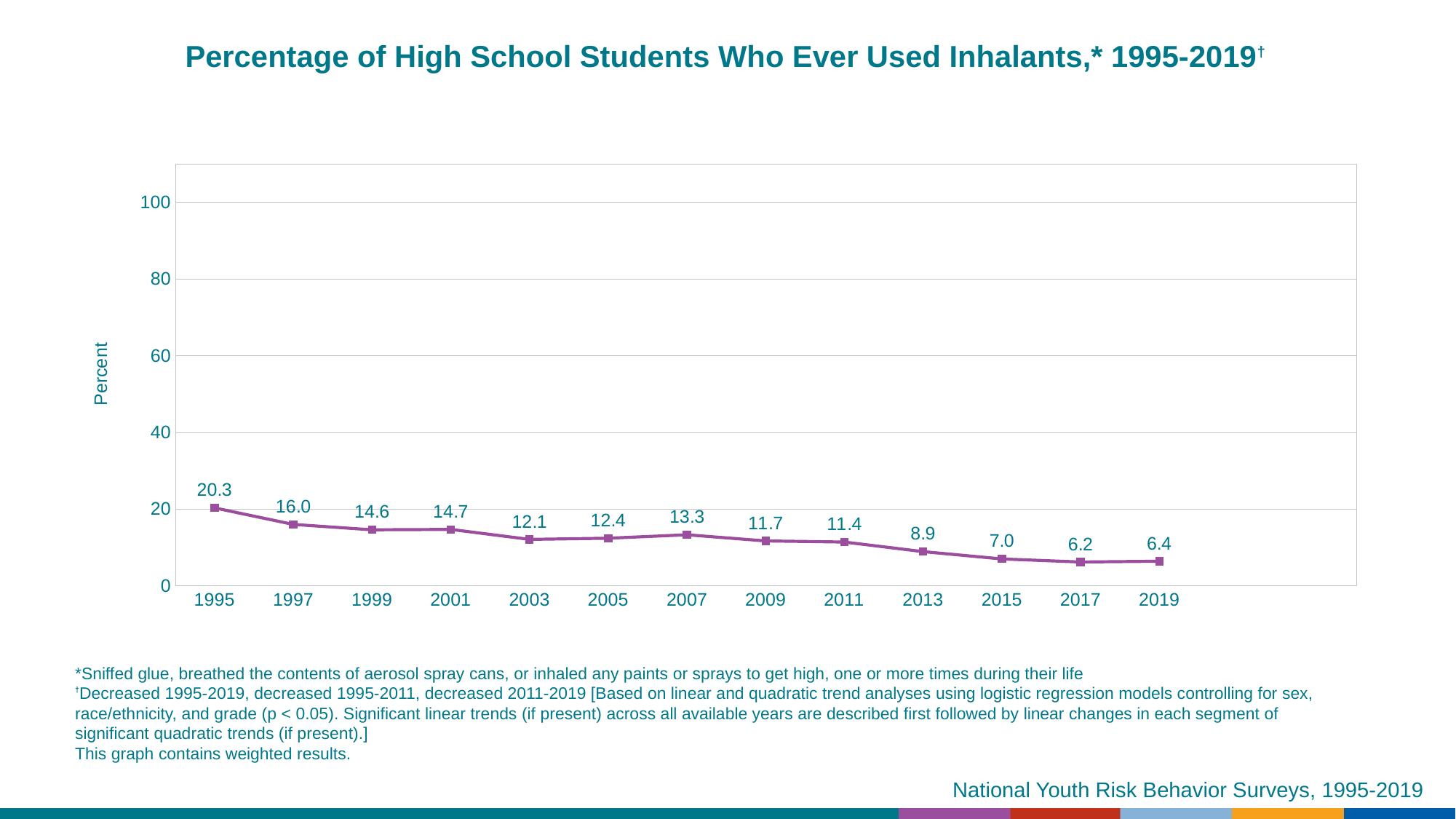
What is the difference between the 2011 value and the 2013 value? 2.5 Is the value for 1997 greater or less than 20? less How many years are plotted on the chart? 13 Which year has the lowest percentage of students who ever used inhalants? 2017 What percentage of high school students had ever used inhalants in 1995? 20.3 Overall, do the values rise or fall from 1995 to 2019? fall Which year has a larger value, 2003 or 2005? 2005 What is the difference between the 1995 value and the 2019 value? 13.9 What is the value plotted for 2007? 13.3 What kind of chart is shown on the slide? line chart Which year has the highest percentage of students who ever used inhalants? 1995 What is the value plotted for 2019? 6.4